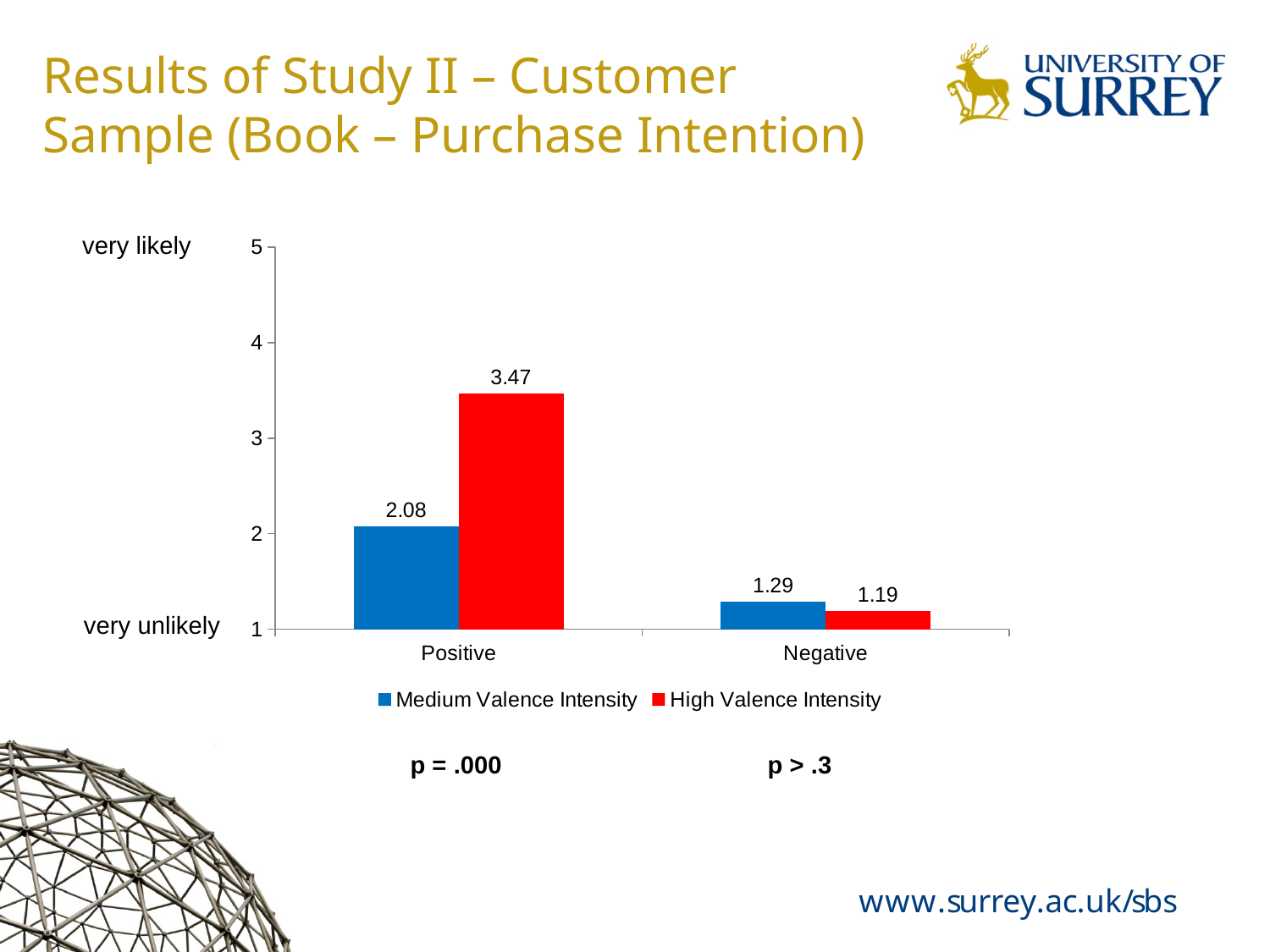
How many series does the legend list? 2 What is the value for Medium Valence Intensity in the Positive category? 2.08 What is the difference between the High Valence Intensity and Medium Valence Intensity values in the Positive category? 1.39 How many categories are shown on the x axis? 2 Is the value for High Valence Intensity in the Positive category greater or less than 3? greater What is the value for Medium Valence Intensity in the Negative category? 1.29 Which bar has the highest value on the chart? High Valence Intensity, Positive In the Positive category, which series has the larger value: Medium Valence Intensity or High Valence Intensity? High Valence Intensity What is the value for High Valence Intensity in the Negative category? 1.19 What is the value for High Valence Intensity in the Positive category? 3.47 What kind of chart is shown on the slide? bar chart Which bar has the lowest value on the chart? High Valence Intensity, Negative